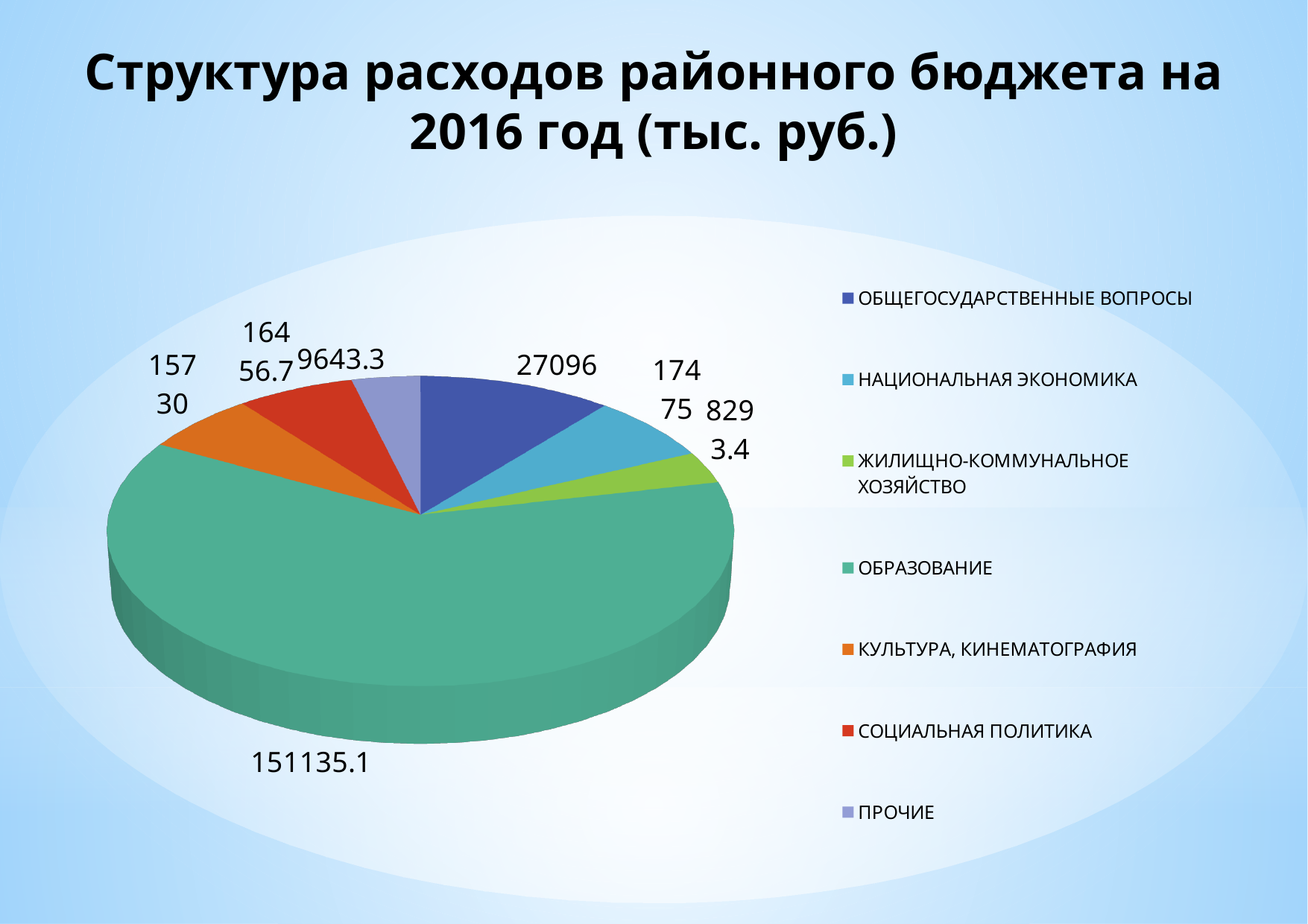
What is the value for ПРОЧИЕ? 9643.3 What is the title of the chart? Структура расходов районного бюджета на 2016 год (тыс. руб.) What is the difference between the value for ОБЩЕГОСУДАРСТВЕННЫЕ ВОПРОСЫ and the value for ПРОЧИЕ? 17452.7 Which category has the largest slice of the pie? ОБРАЗОВАНИЕ How many categories does the legend list? 7 Which category has the smallest slice of the pie? ЖИЛИЩНО-КОММУНАЛЬНОЕ ХОЗЯЙСТВО Which is larger, the value for ОБРАЗОВАНИЕ or the value for ОБЩЕГОСУДАРСТВЕННЫЕ ВОПРОСЫ? ОБРАЗОВАНИЕ What is the difference between the value for ОБРАЗОВАНИЕ and the value for ОБЩЕГОСУДАРСТВЕННЫЕ ВОПРОСЫ? 124039.1 What colour is the slice for ОБРАЗОВАНИЕ? Green (teal) What kind of chart is shown on the slide? Pie chart What is the value for ОБЩЕГОСУДАРСТВЕННЫЕ ВОПРОСЫ? 27096 What is the value for ОБРАЗОВАНИЕ? 151135.1